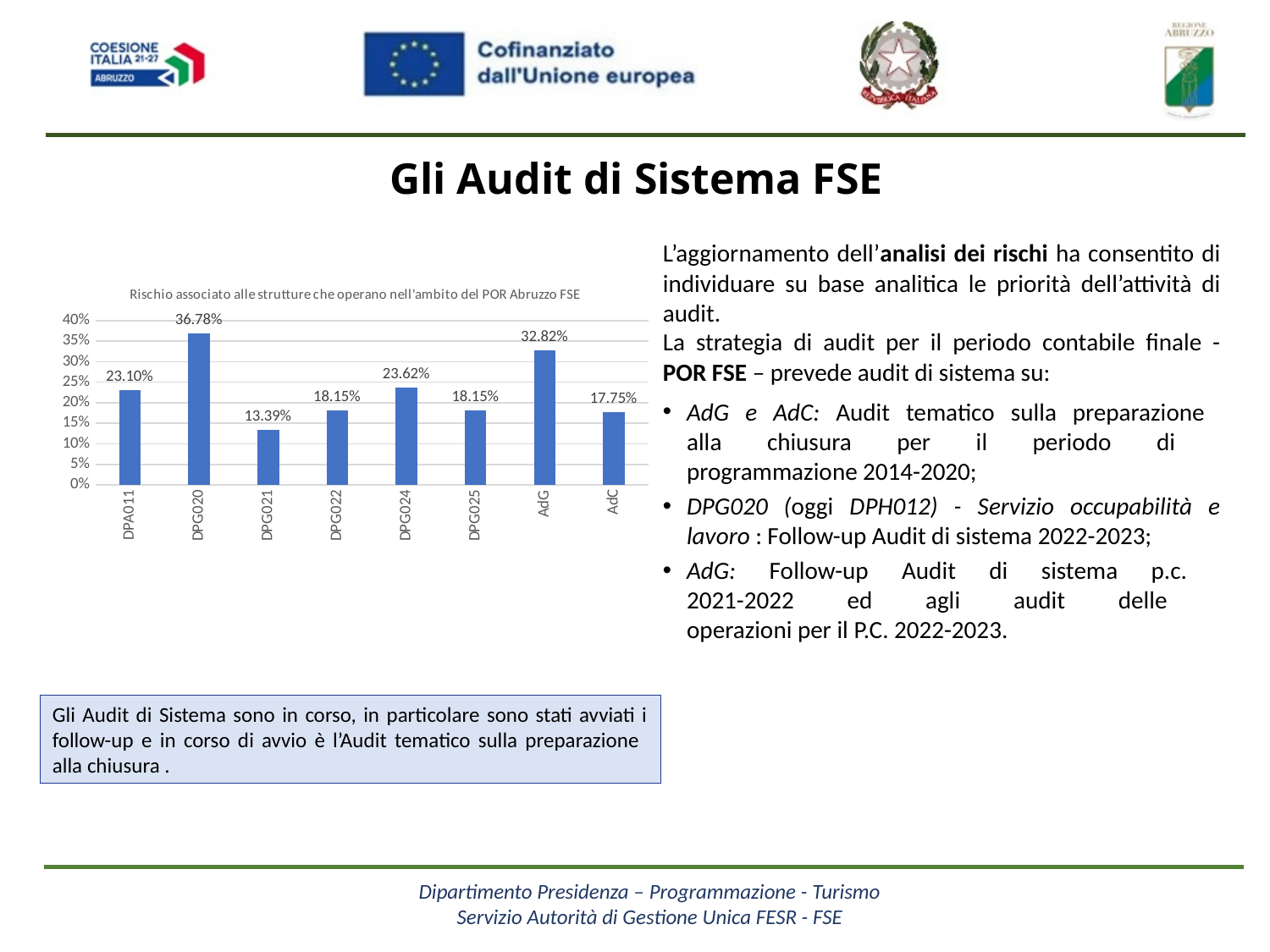
What is the value for AdG? 32.82% What is the value for DPG020? 36.78% What is the title of the chart? Rischio associato alle strutture che operano nell'ambito del POR Abruzzo FSE Which category has the lowest value? DPG021 What is the difference between the values for DPG020 and AdG? 3.96% Is the value for DPG022 greater or less than 20%? less What is the value for AdC? 17.75% Which category has the highest value? DPG020 What kind of chart is shown on the slide? bar chart What is the value for DPG021? 13.39% Which is larger, the value for DPA011 or the value for DPG024? DPG024 How many categories are shown on the x axis? 8